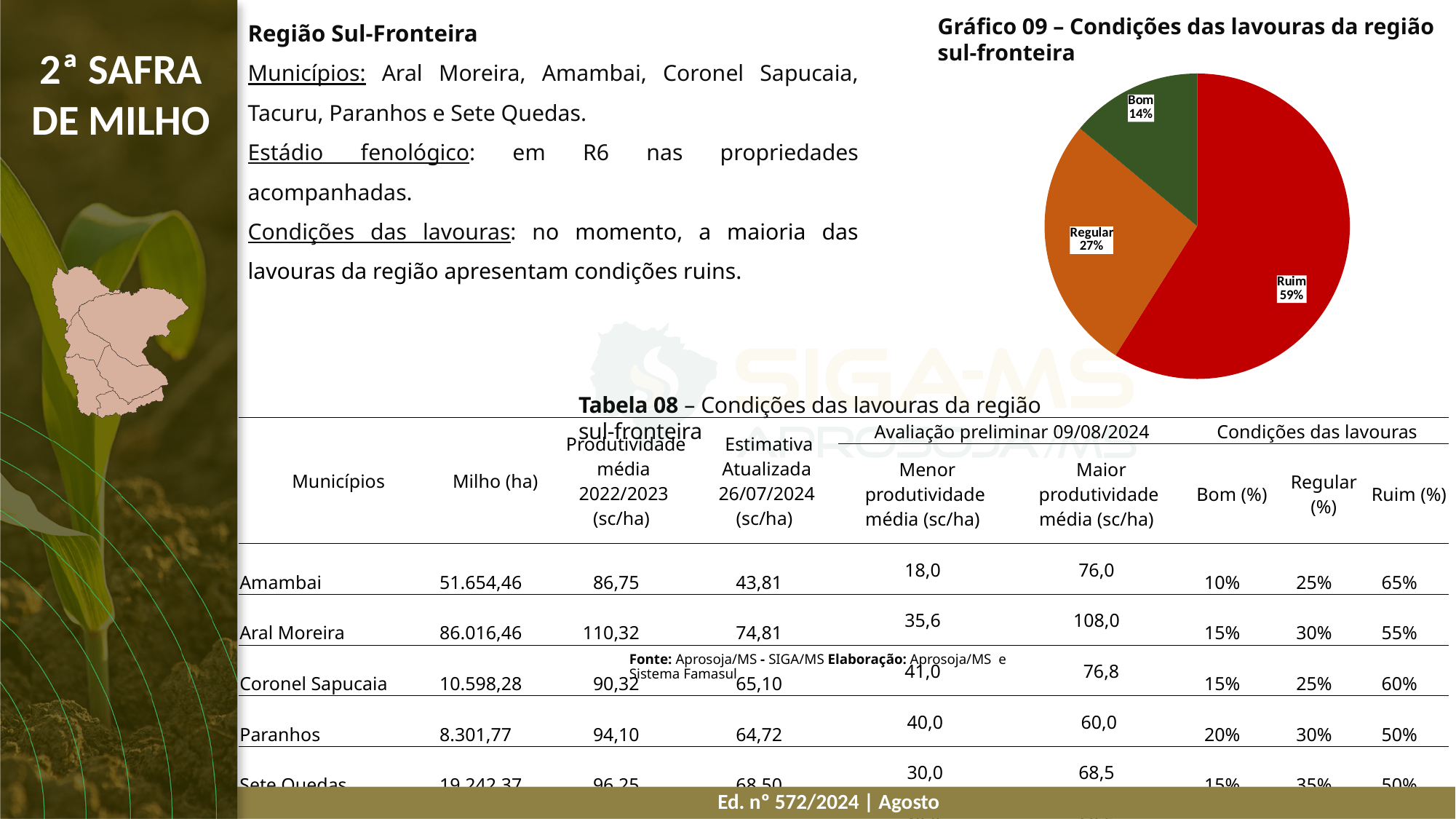
In Gráfico 09, what percentage of the lavouras are in the 'Regular' condition? 27% How many slices does the pie chart in Gráfico 09 have? 3 In Gráfico 09, what percentage of the lavouras are in the 'Bom' condition? 14% In Gráfico 09, which condition category has the smallest share? Bom What is the title of the pie chart on the slide? Gráfico 09 – Condições das lavouras da região sul-fronteira In Gráfico 09, what colour is the 'Ruim' slice? Red In Gráfico 09, what is the difference in percentage points between the 'Ruim' and 'Regular' slices? 32 What type of chart is Gráfico 09? Pie chart In Gráfico 09, which slice is larger: 'Regular' or 'Bom'? Regular In Gráfico 09, what is the difference in percentage points between the 'Regular' and 'Bom' slices? 13 In Gráfico 09, which condition category has the largest share? Ruim In Gráfico 09, what percentage of the lavouras are in the 'Ruim' condition? 59%